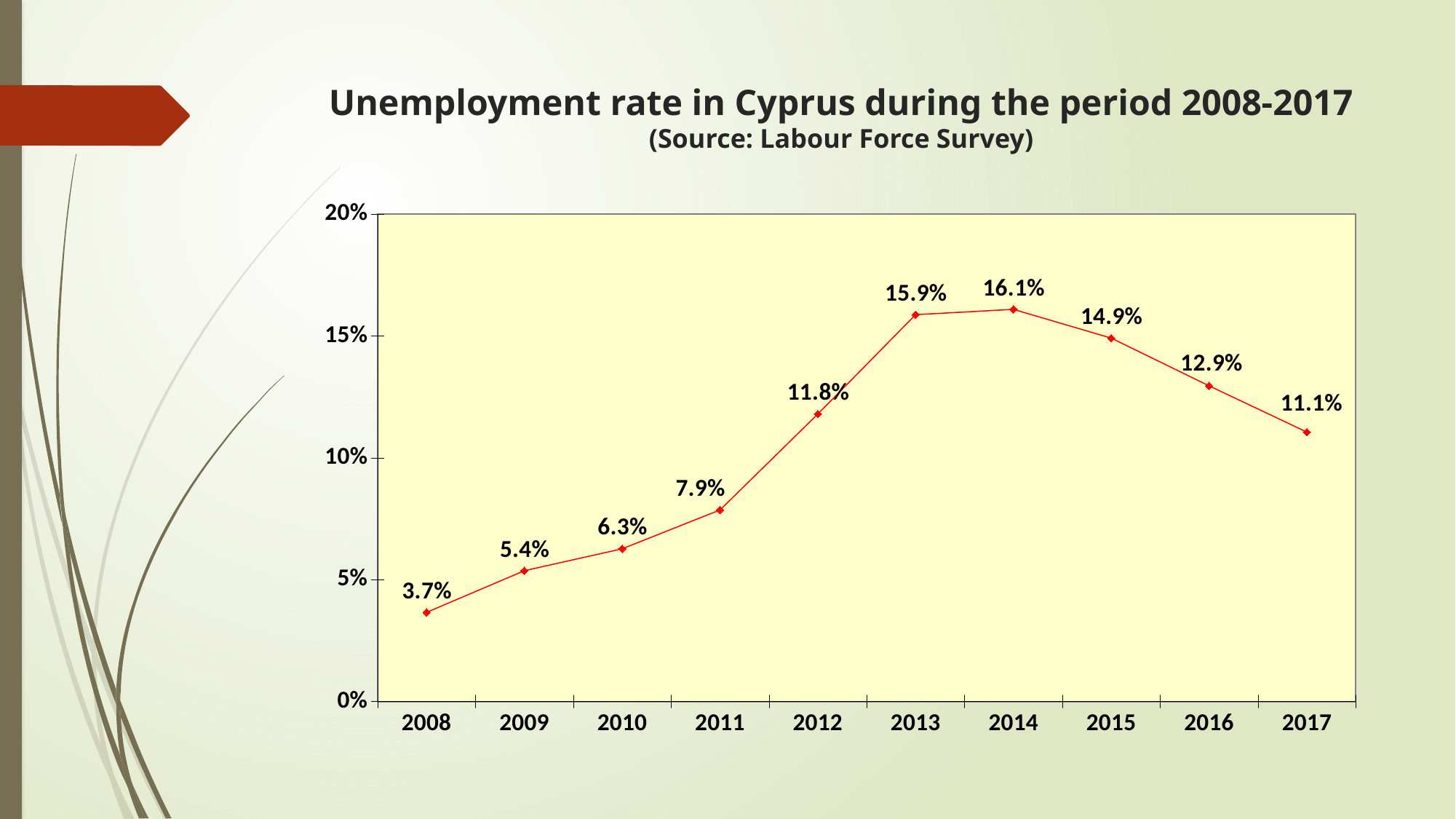
What kind of chart is shown on the slide? Line chart What was the unemployment rate in Cyprus in 2014? 16.1% How many years are plotted on the chart? 10 Which year had a higher unemployment rate, 2015 or 2016? 2015 Is the unemployment rate for 2013 greater or less than 15%? greater What is the difference between the unemployment rate in 2012 and in 2011? 3.9% What is the source of the data cited in the chart title? Labour Force Survey In which year was the unemployment rate lowest? 2008 What was the unemployment rate in Cyprus in 2017? 11.1% In which year was the unemployment rate highest? 2014 What was the unemployment rate in Cyprus in 2008? 3.7% What is the difference between the unemployment rate in 2014 and in 2008? 12.4%